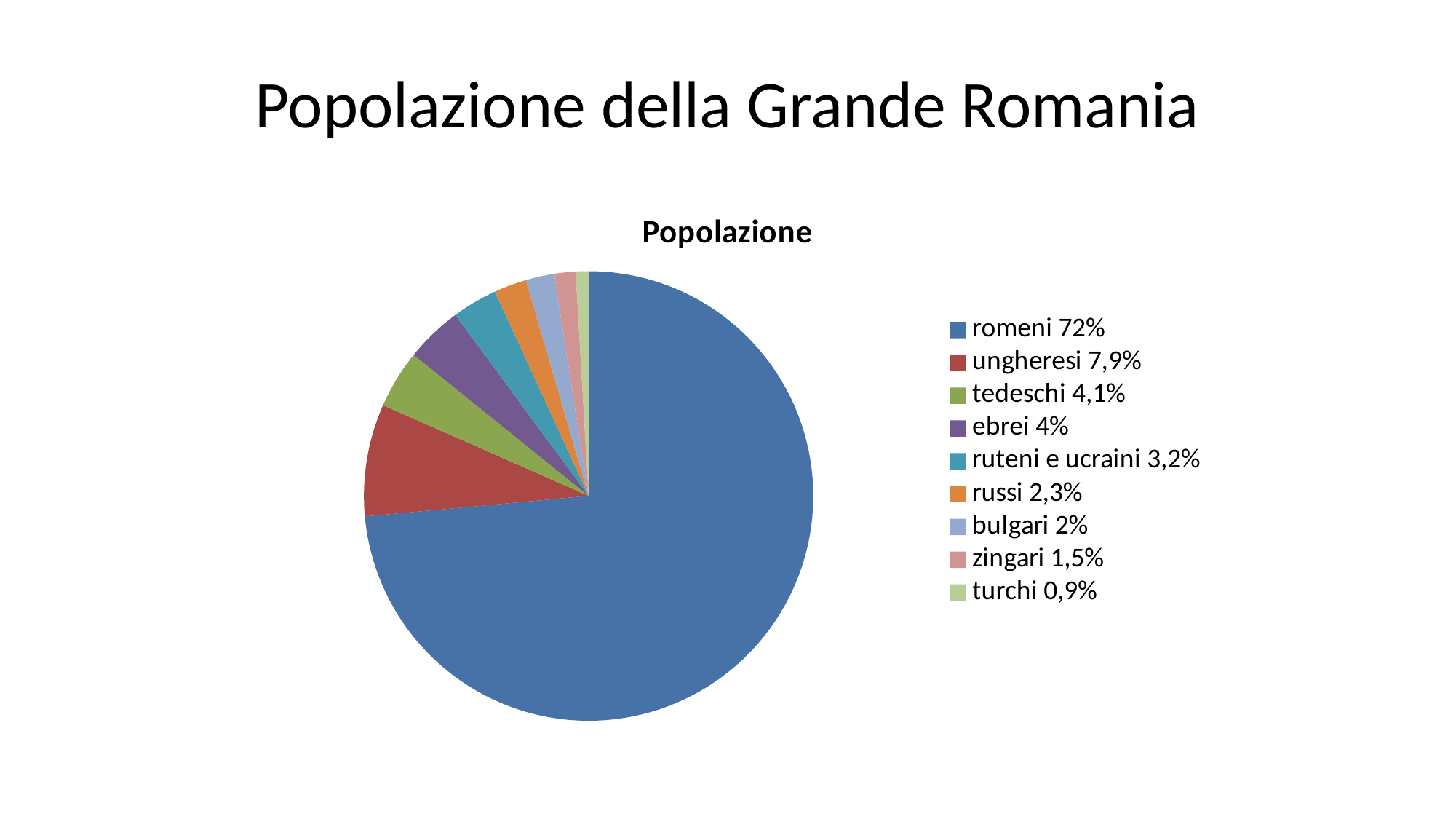
What colour is the slice for bulgari? light blue What share of the population is turchi? 0,9% Which category has the smallest share of the pie? turchi Which is larger, the share for tedeschi or the share for russi? tedeschi What kind of chart is shown on the slide? pie chart How many categories does the pie chart have? 9 What share of the population is ungheresi? 7,9% What share of the population is romeni? 72% Which category has the largest share of the pie? romeni What is the difference between the share for ungheresi and the share for ebrei? 3,9% What is the chart's title? Popolazione